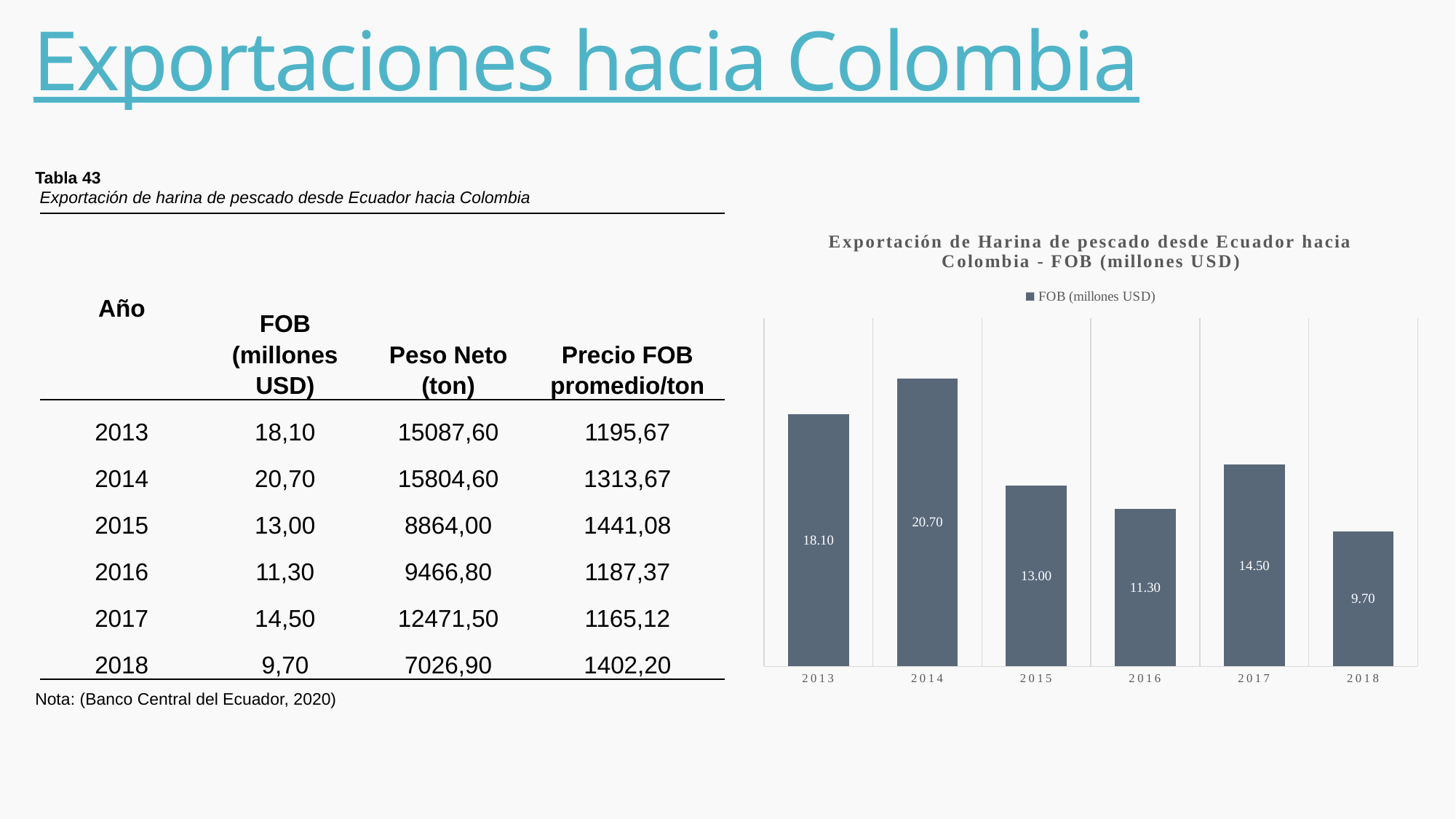
How many series does the chart legend list? 1 How many years are plotted in the chart? 6 Which year has a larger FOB value in the chart, 2015 or 2017? 2017 Which year has the lowest FOB value in the chart? 2018 What is the FOB value (millones USD) for 2014 in the chart? 20.70 What is the FOB value (millones USD) for 2018 in the chart? 9.70 What is the difference between the FOB values for 2013 and 2015 in the chart? 5.10 What is the FOB value (millones USD) for 2016 in the chart? 11.30 Which year has the highest FOB value in the chart? 2014 What is the legend entry shown in the chart? FOB (millones USD) What type of chart is shown on the slide? bar chart What is the difference between the FOB values for 2014 and 2018 in the chart? 11.00